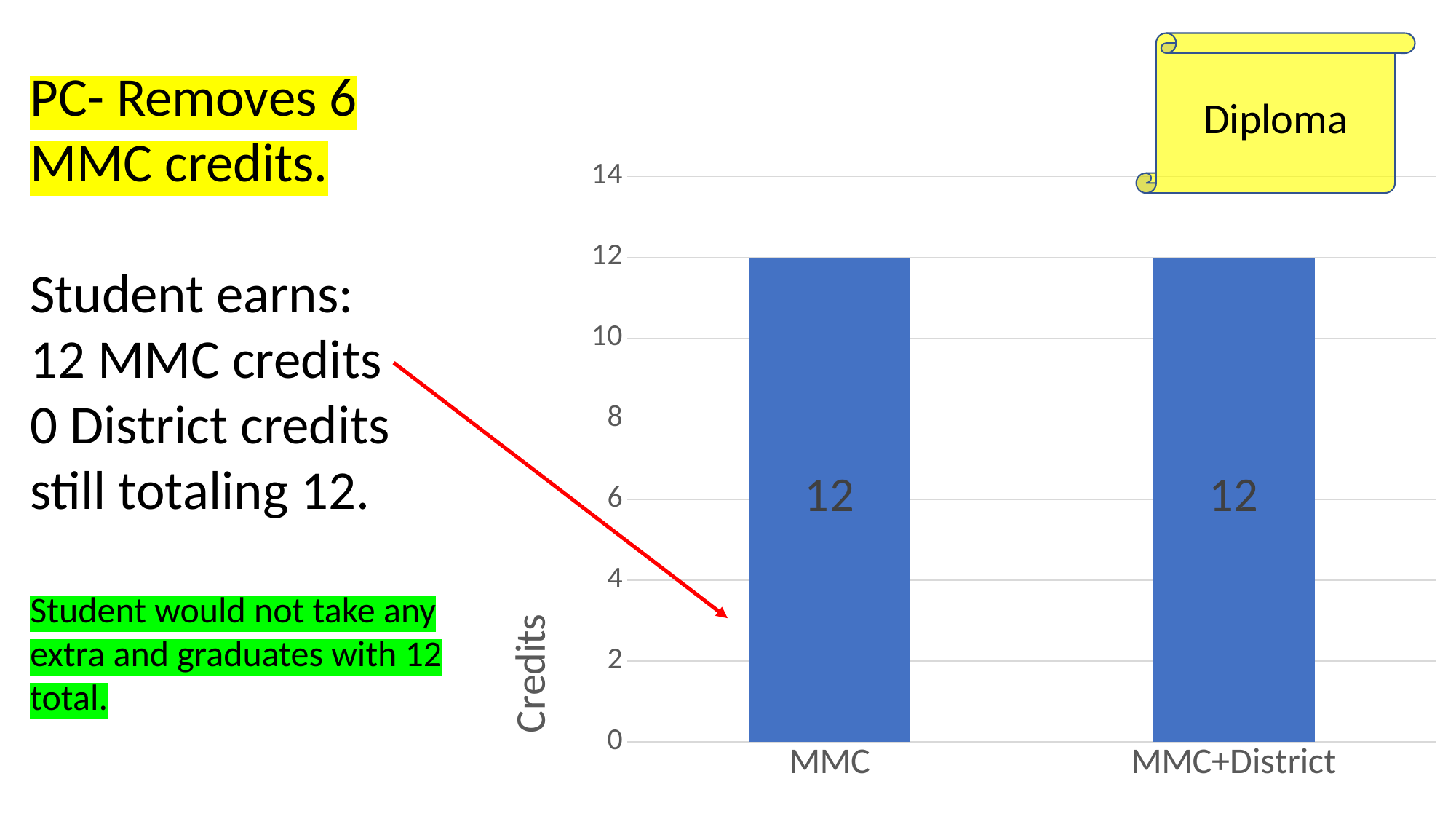
What is the label of the vertical axis? Credits What is the difference between the values for MMC and MMC+District? 0 Do the values rise, fall or stay the same from MMC to MMC+District? stay the same Is the value for MMC+District greater or less than 14? less What is the value for MMC+District? 12 What kind of chart is shown on the slide? bar chart What is the value for MMC? 12 What is the highest value shown on the vertical axis? 14 Is the value for MMC greater or less than 10? greater How many categories are shown on the x axis? 2